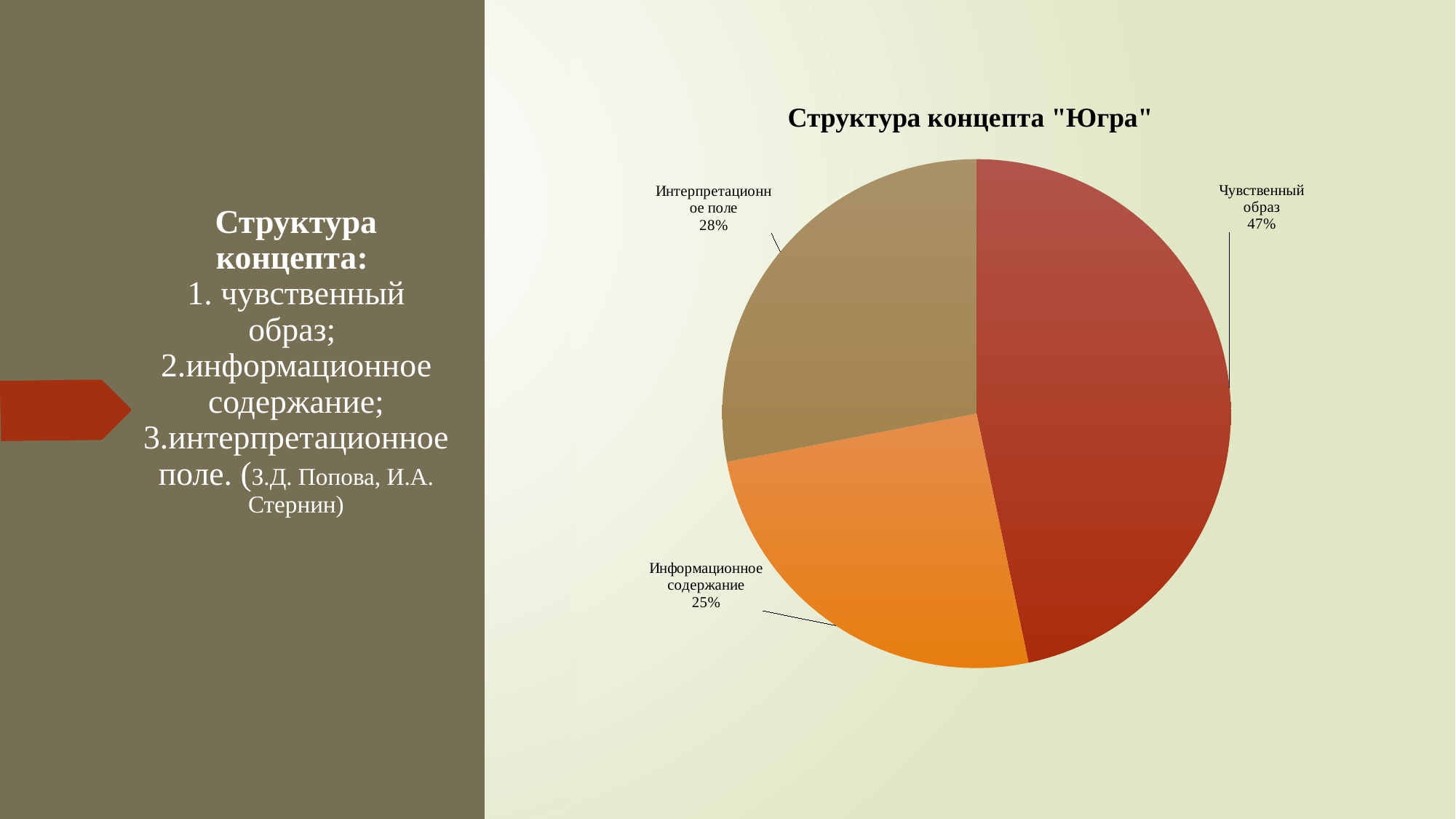
What share of the pie does Интерпретационное поле have? 28% What share of the pie does Информационное содержание have? 25% Which slice of the pie is the smallest? Информационное содержание Which slice of the pie is the largest? Чувственный образ What type of chart is shown on the slide? pie chart What share of the pie does Чувственный образ have? 47% What is the title of the chart? Структура концепта "Югра" What colour is the slice for Чувственный образ? red What is the difference between the shares of Чувственный образ and Интерпретационное поле? 19% How many slices does the pie chart have? 3 Which is larger: the share of Чувственный образ or the share of Информационное содержание? Чувственный образ What is the difference between the shares of Интерпретационное поле and Информационное содержание? 3%